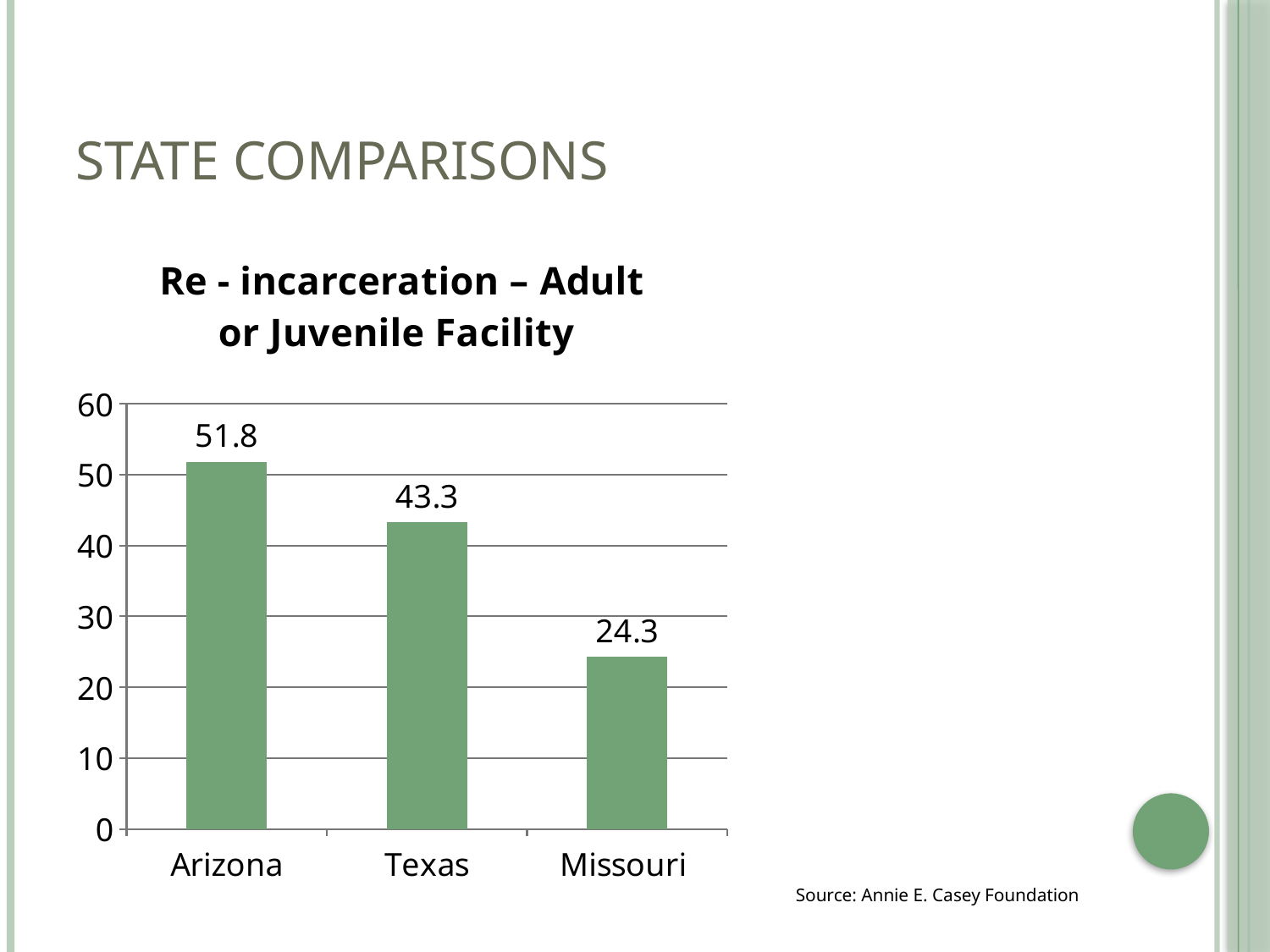
Which is larger, the value for Texas or the value for Missouri? Texas How many states are shown in the chart? 3 What is the difference between the values for Arizona and Texas? 8.5 Which state has the highest value? Arizona What is the value for Texas? 43.3 Is the value for Texas greater or less than 40? greater Which state has the lowest value? Missouri What kind of chart is shown on the slide? bar chart What is the value for Arizona? 51.8 What is the difference between the values for Arizona and Missouri? 27.5 What is the value for Missouri? 24.3 What is the title of the chart? Re - incarceration – Adult or Juvenile Facility